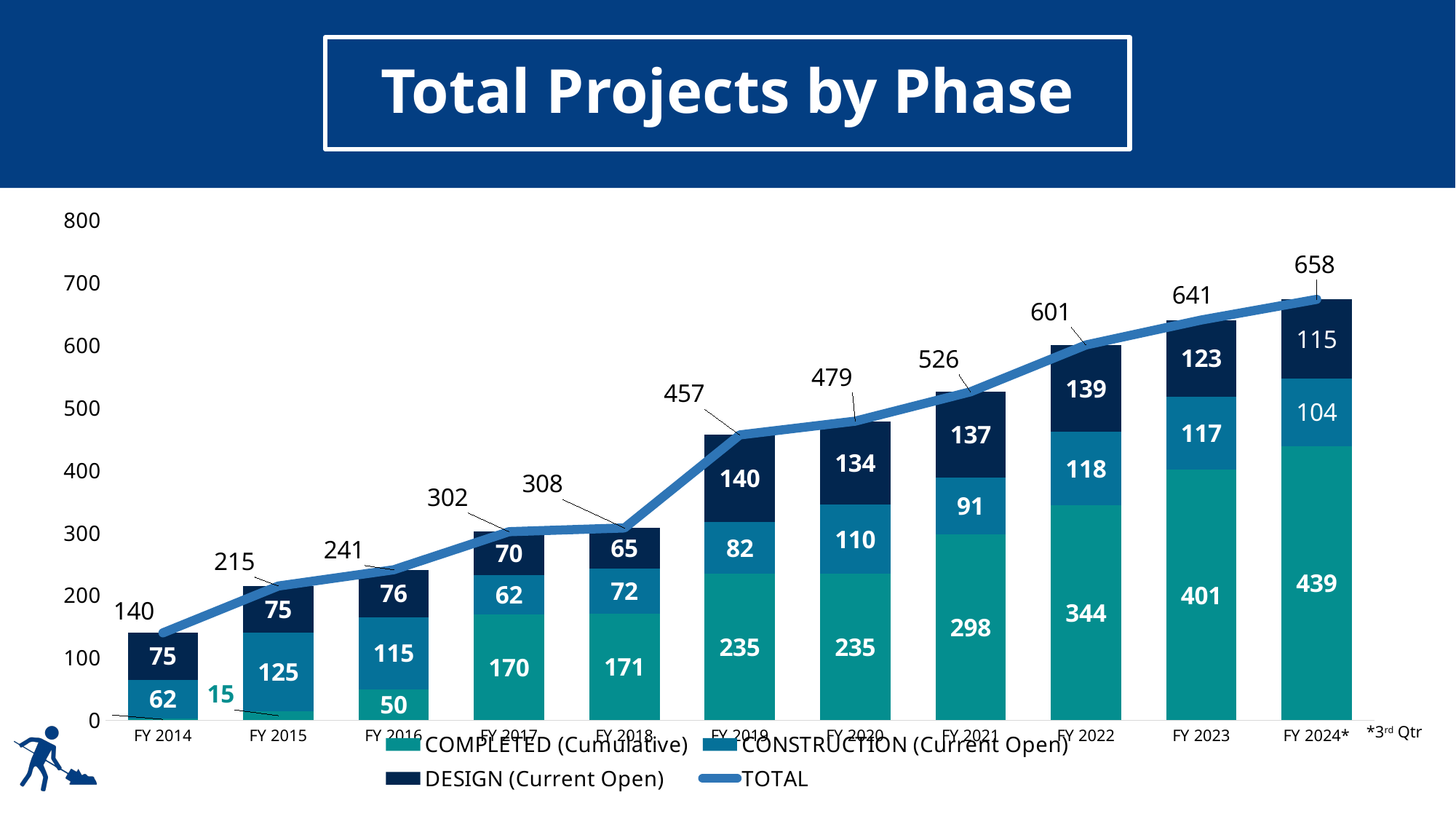
What kind of chart is shown on the slide? Stacked bar chart with a line Which fiscal year has the lowest TOTAL value? FY 2014 What is the COMPLETED (Cumulative) value for FY 2022? 344 What is the DESIGN (Current Open) value for FY 2019? 140 Does the TOTAL line rise or fall from FY 2014 to FY 2024*? Rise Which fiscal year has the highest TOTAL value? FY 2024* How many series does the legend list? 4 What is the CONSTRUCTION (Current Open) value for FY 2015? 125 What is the difference between the TOTAL values for FY 2023 and FY 2022? 40 Which is larger, the DESIGN (Current Open) value for FY 2020 or for FY 2021? FY 2021 What is the TOTAL value for FY 2024*? 658 How many fiscal years are shown on the x axis? 11